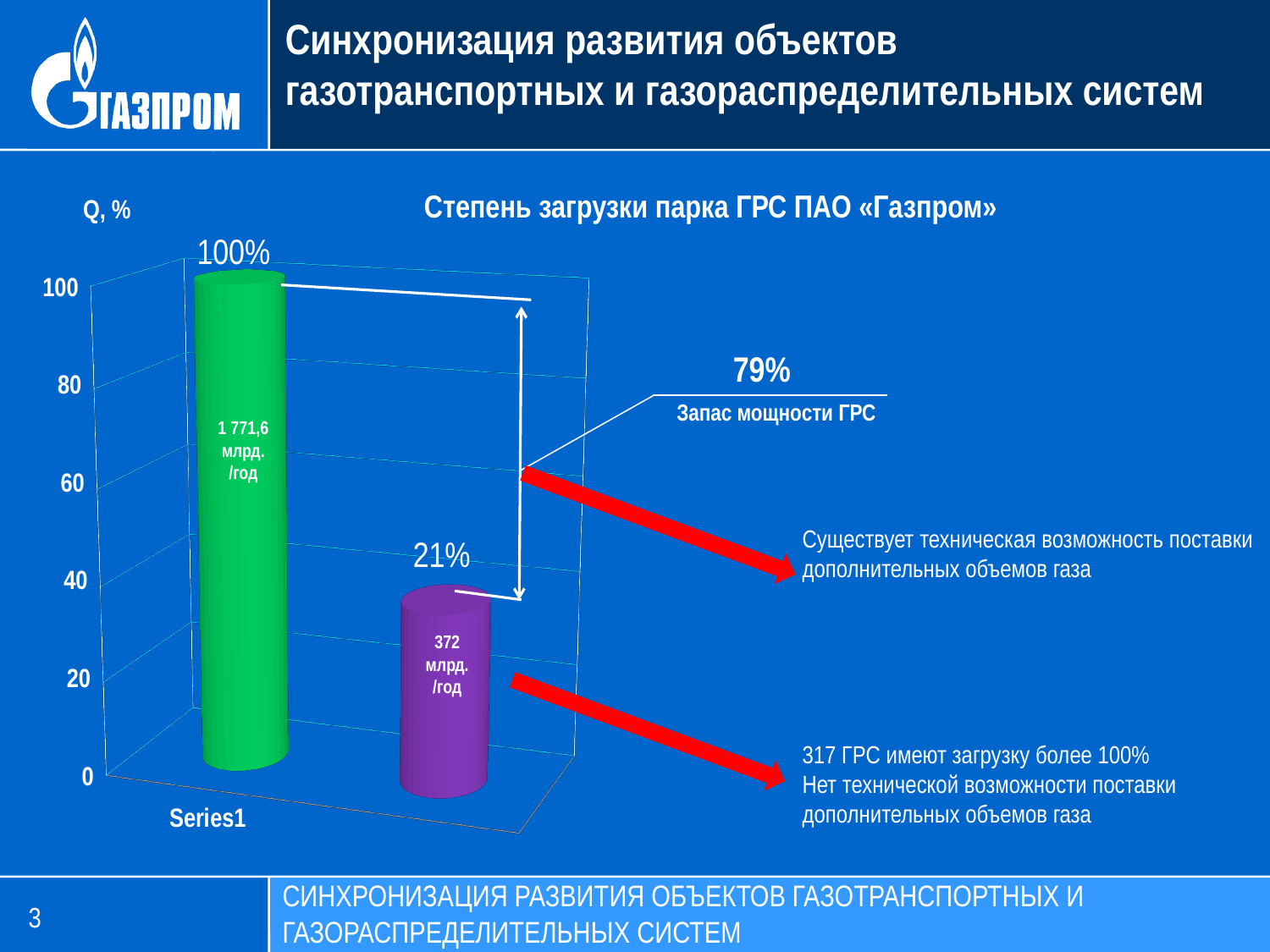
What is the value shown above the green bar? 100% What is the value shown above the purple bar? 21% What volume label is printed inside the green bar? 1 771,6 млрд./год What volume label is printed inside the purple bar? 372 млрд./год What is the title of the chart? Степень загрузки парка ГРС ПАО «Газпром» What label is shown on the vertical axis of the chart? Q, % How many bars are plotted on the chart? 2 Which bar is taller, the green one or the purple one? the green one What kind of chart is shown on the slide? bar chart What is the difference between the green bar's value (100%) and the purple bar's value (21%)? 79% What percentage is labelled as «Запас мощности ГРС» on the chart? 79%